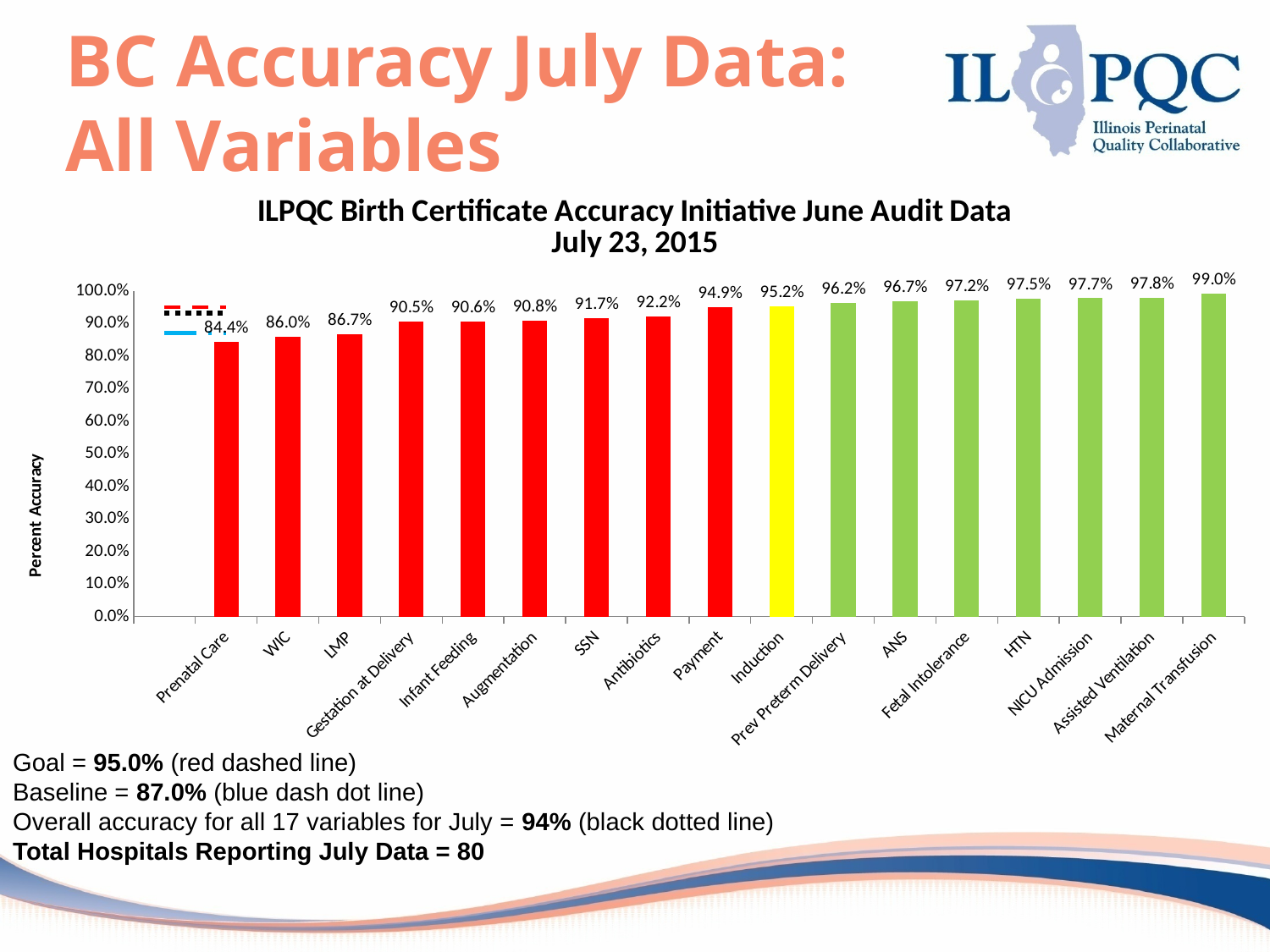
What is the percent accuracy for Prenatal Care? 84.4% What is the percent accuracy for Antibiotics? 92.2% What type of chart is shown on the slide? Bar chart What is the percent accuracy for Induction? 95.2% What is the label on the vertical axis of the chart? Percent Accuracy How many variables are plotted on the chart? 17 Which has a higher percent accuracy, LMP or SSN? SSN Do the percent accuracy values rise or fall from left to right across the variables? Rise What is the difference in percent accuracy between Maternal Transfusion and Prenatal Care? 14.6% What is the difference in percent accuracy between Payment and WIC? 8.9% Which variable has the lowest percent accuracy? Prenatal Care Which variable has the highest percent accuracy? Maternal Transfusion